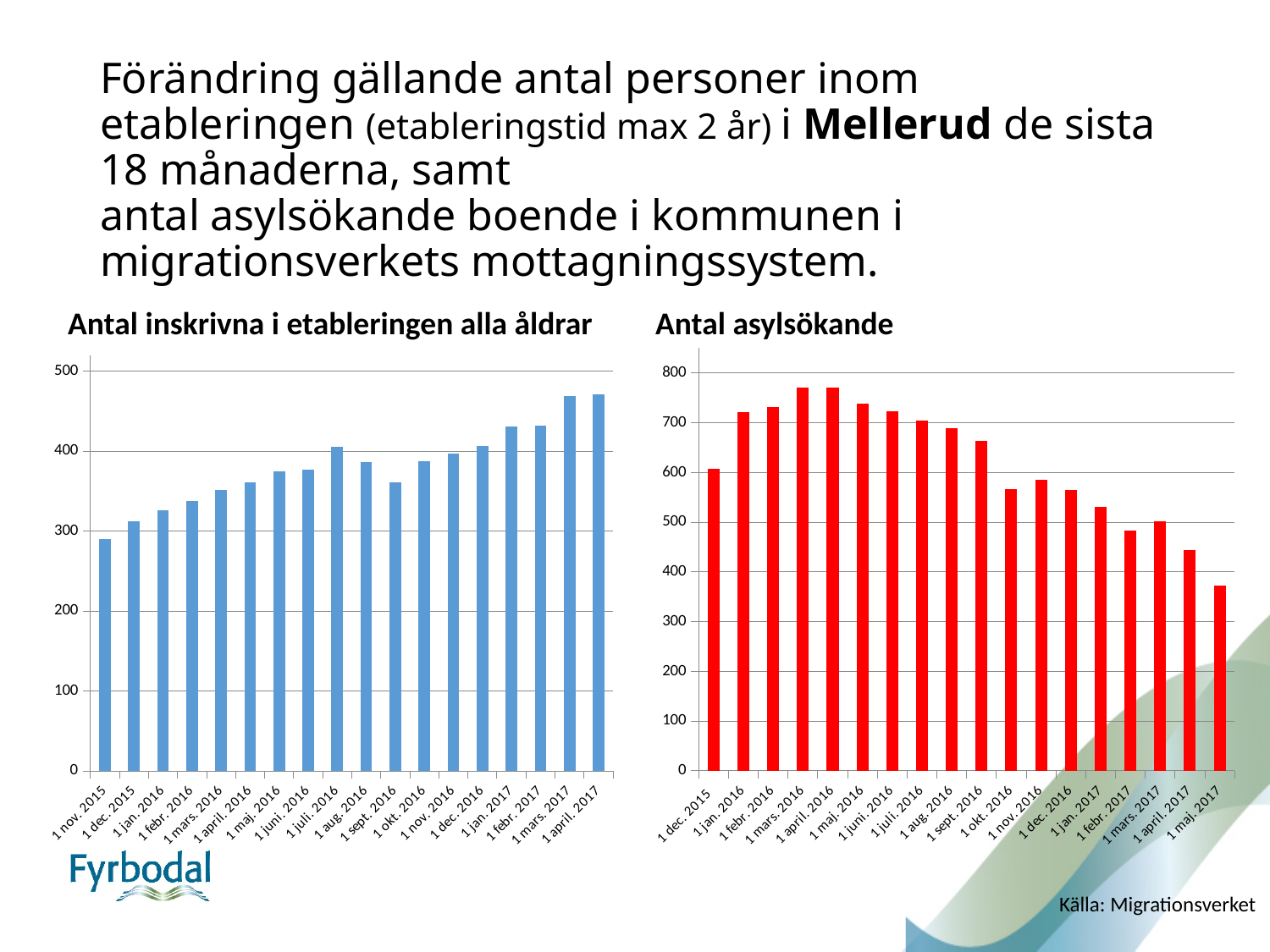
How many months (bars) are shown in the 'Antal asylsökande' chart? 18 What kind of chart is the 'Antal inskrivna i etableringen alla åldrar' chart on the left? Bar chart In the 'Antal asylsökande' chart, is the value for 1 maj. 2017 greater or less than 400? less In the 'Antal asylsökande' chart, which month has the lowest value? 1 maj. 2017 In the 'Antal inskrivna i etableringen alla åldrar' chart, is the value for 1 mars. 2017 greater or less than 400? greater How many months (bars) are shown in the 'Antal inskrivna i etableringen alla åldrar' chart? 18 In the 'Antal asylsökande' chart, which is larger, the value for 1 dec. 2015 or the value for 1 jan. 2016? 1 jan. 2016 In the 'Antal asylsökande' chart, is the value for 1 mars. 2016 greater or less than 700? greater What colour are the bars in the 'Antal asylsökande' chart? Red In the 'Antal inskrivna i etableringen alla åldrar' chart, which month has the lowest value? 1 nov. 2015 In the 'Antal asylsökande' chart, do the values rise or fall from 1 april. 2016 to 1 maj. 2017? fall